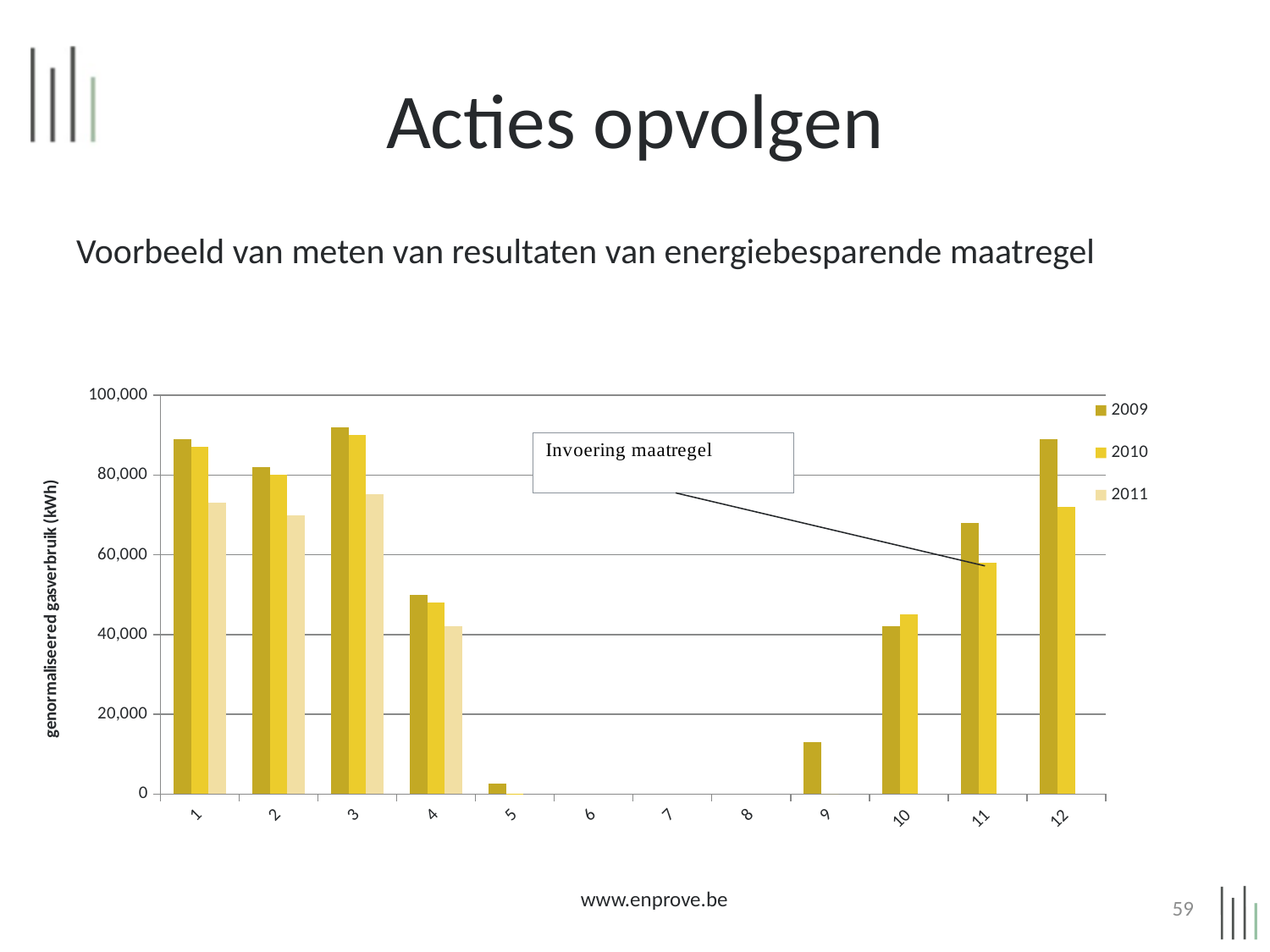
Is the 2009 value for category 3 greater or less than 80,000? greater Is the 2011 value for category 1 greater or less than 80,000? less Do the 2011 values rise or fall from category 1 to category 4? fall Is the 2010 value for category 10 greater or less than 40,000? greater How many categories are shown along the x axis? 12 For category 12, which series has the larger value, 2009 or 2010? 2009 For category 4, which series has the lowest value? 2011 What kind of chart is shown on the slide? bar chart How many series does the legend list? 3 For category 11, which series has the larger value, 2009 or 2010? 2009 What is the label on the y axis of the chart? genormaliseered gasverbruik (kWh)